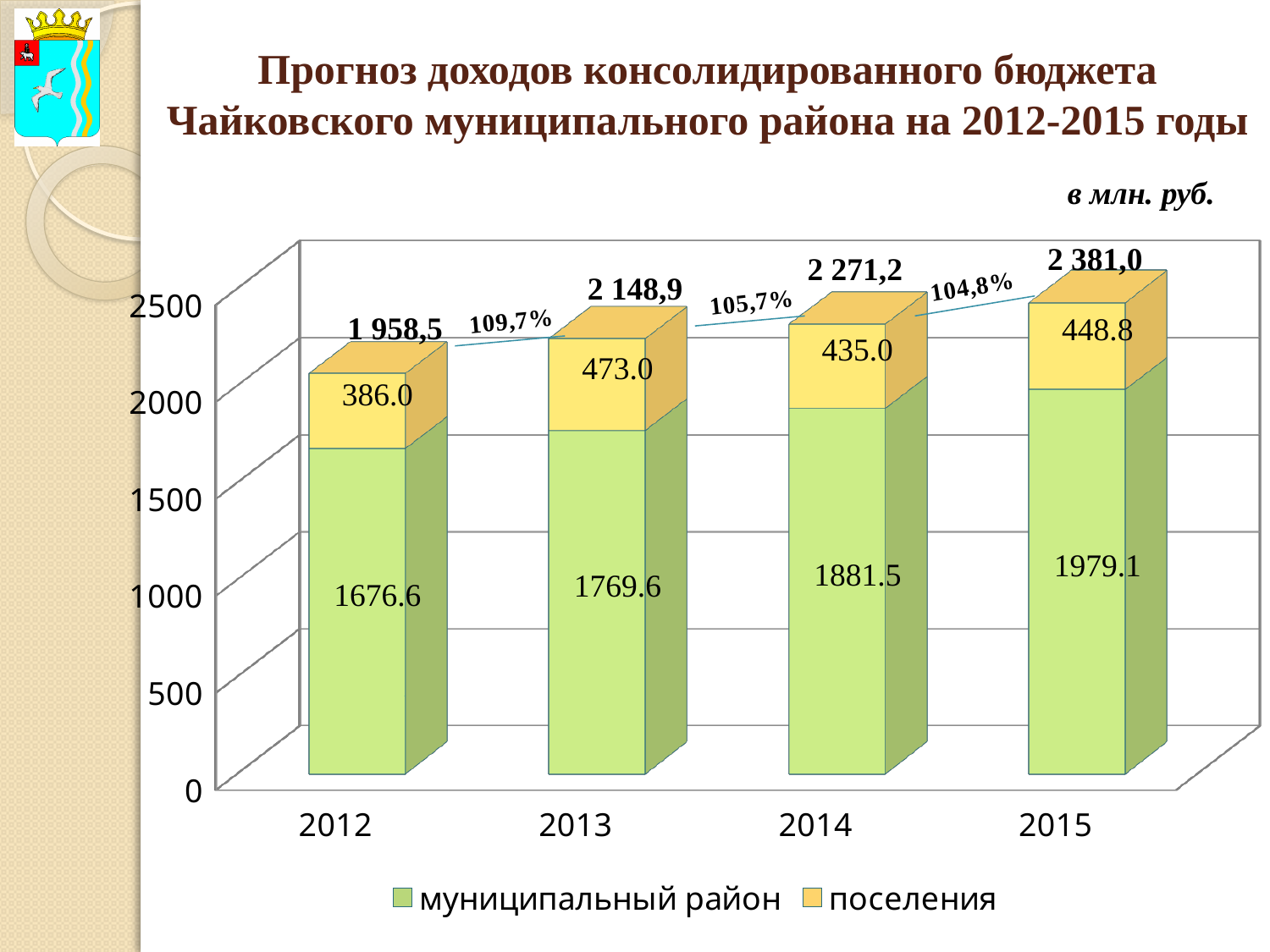
Which year has the highest value for поселения? 2013 What is the value for муниципальный район in 2012? 1676.6 Do the total values rise or fall from 2012 to 2015? rise How many years are shown on the x axis? 4 What is the difference between the муниципальный район values for 2014 and 2013? 111.9 How many series does the legend list? 2 What kind of chart is shown on the slide? stacked bar chart What is the total of the stacked bar for 2014? 2 271,2 Which year has the lowest total consolidated budget revenue? 2012 What is the value for муниципальный район in 2015? 1979.1 What is the value for поселения in 2013? 473.0 Is the value for поселения in 2015 larger or smaller than in 2014? larger